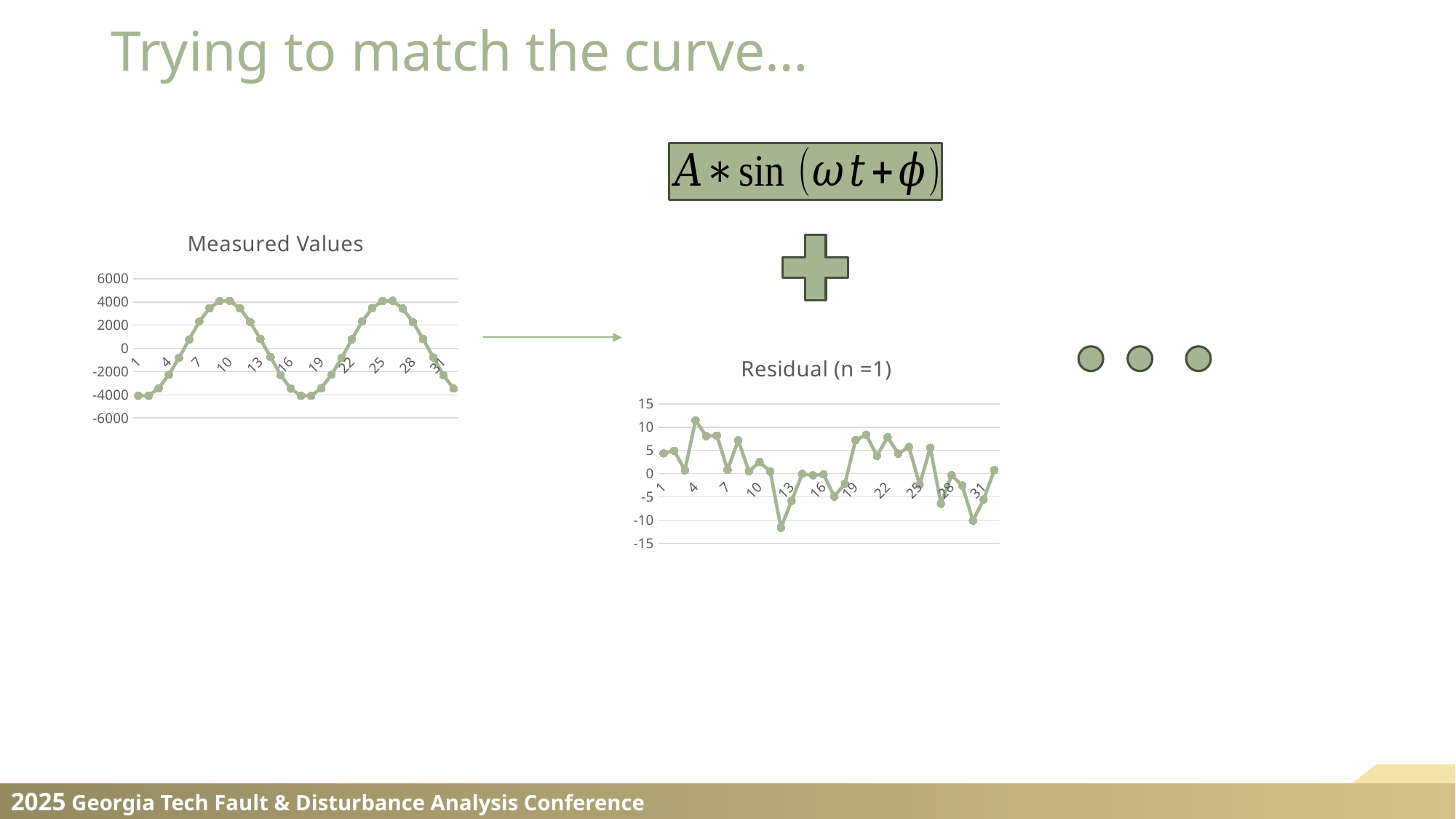
In the Residual (n =1) chart, is the value at x = 4 greater or less than 5? greater In the Measured Values chart, is the value at x = 1 greater or less than -2000? less In the Measured Values chart, is the value at x = 16 greater or less than -2000? less What kind of chart is the Residual (n =1) chart? line chart In the Measured Values chart, which is larger, the value at x = 10 or the value at x = 16? x = 10 In the Residual (n =1) chart, which is larger, the value at x = 4 or the value at x = 13? x = 4 What is the highest tick shown on the y axis of the Residual (n =1) chart? 15 What is the title of the chart on the left of the slide? Measured Values What kind of chart is the Measured Values chart? line chart